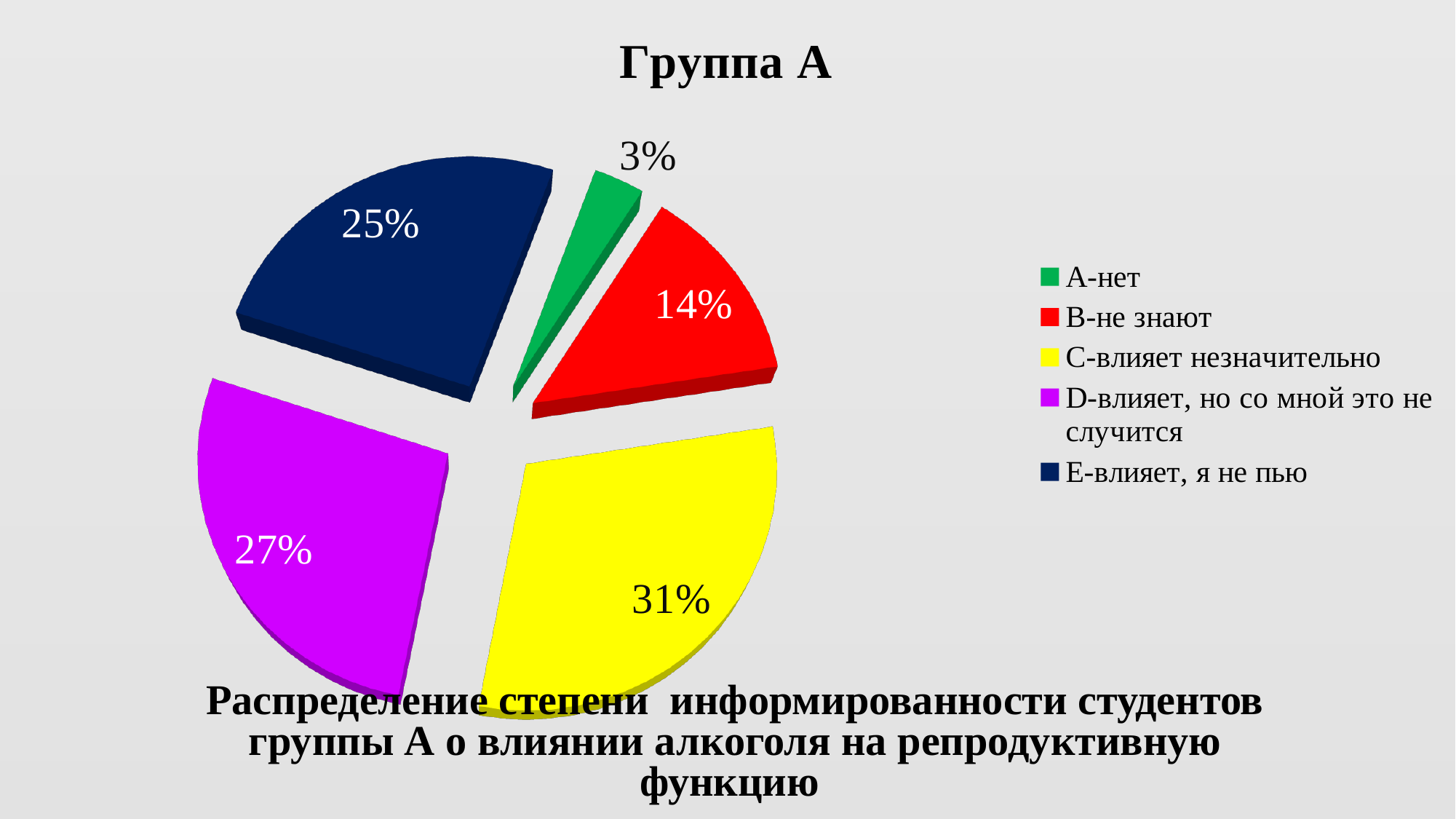
Which colour represents "B-не знают" in the legend? red What share of the pie is labelled "B-не знают"? 14% What share of the pie is labelled "E-влияет, я не пью"? 25% Which category has the largest share of the pie? C-влияет незначительно How many slices does the pie chart have? 5 What kind of chart is shown on the slide? pie chart What share of the pie is labelled "A-нет"? 3% Which category has the smallest share of the pie? A-нет What is the difference between the shares for "D-влияет, но со мной это не случится" and "E-влияет, я не пью"? 2% What is the chart's title? Группа А